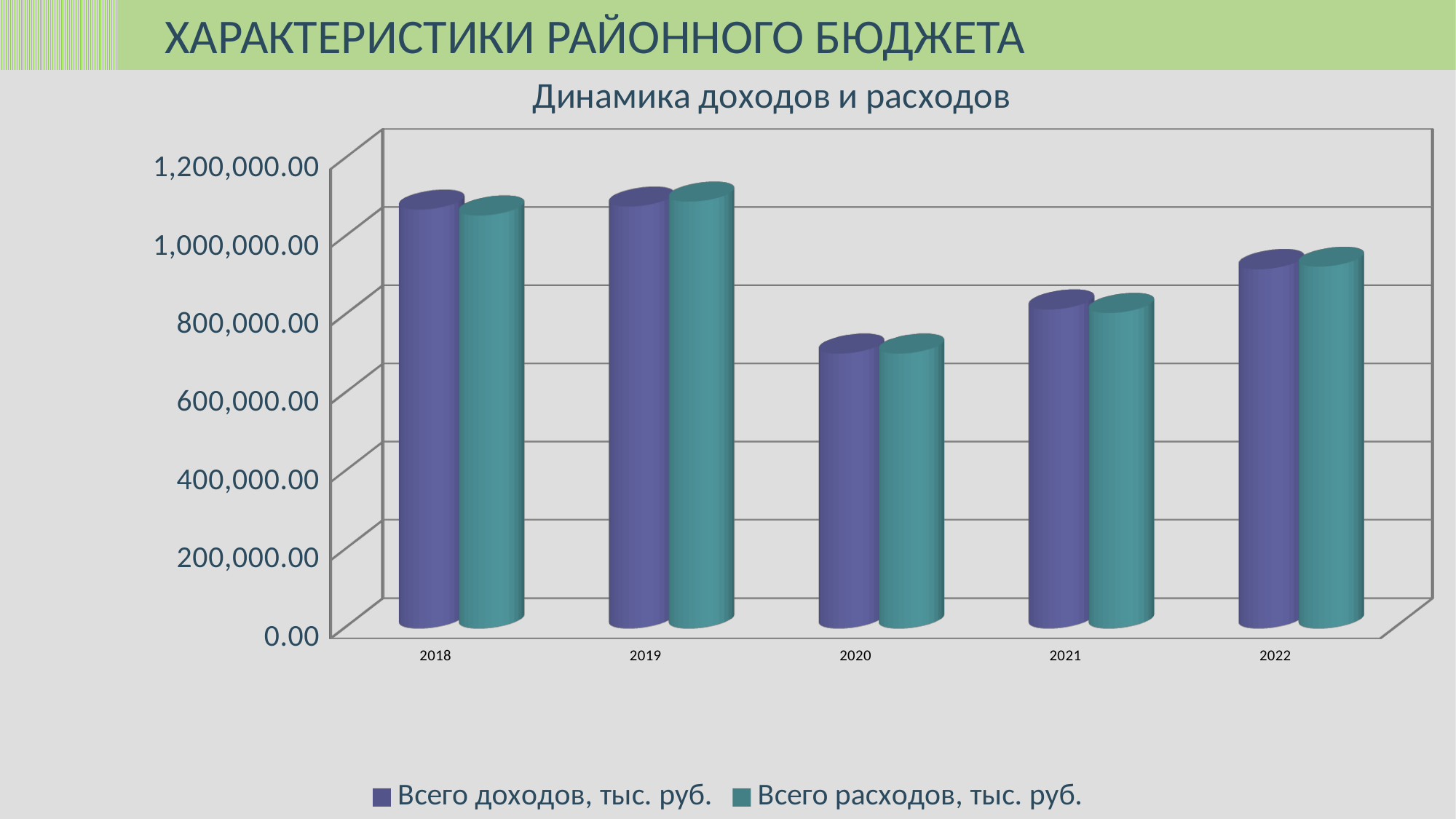
How many series does the legend list? 2 What kind of chart is shown on the slide? bar chart Is the value for Всего расходов, тыс. руб. in 2022 greater or less than 1,000,000.00? less What is the title of the chart? Динамика доходов и расходов Is the value for Всего доходов, тыс. руб. in 2020 greater or less than 800,000.00? less Do the values for Всего доходов, тыс. руб. rise or fall from 2020 to 2022? rise Is the value for Всего доходов, тыс. руб. in 2018 greater or less than 1,000,000.00? greater How many years are shown on the x axis? 5 Which year has the lowest value for Всего доходов, тыс. руб.? 2020 Which year has the lowest value for Всего расходов, тыс. руб.? 2020 Which series is shown in teal in the legend? Всего расходов, тыс. руб.